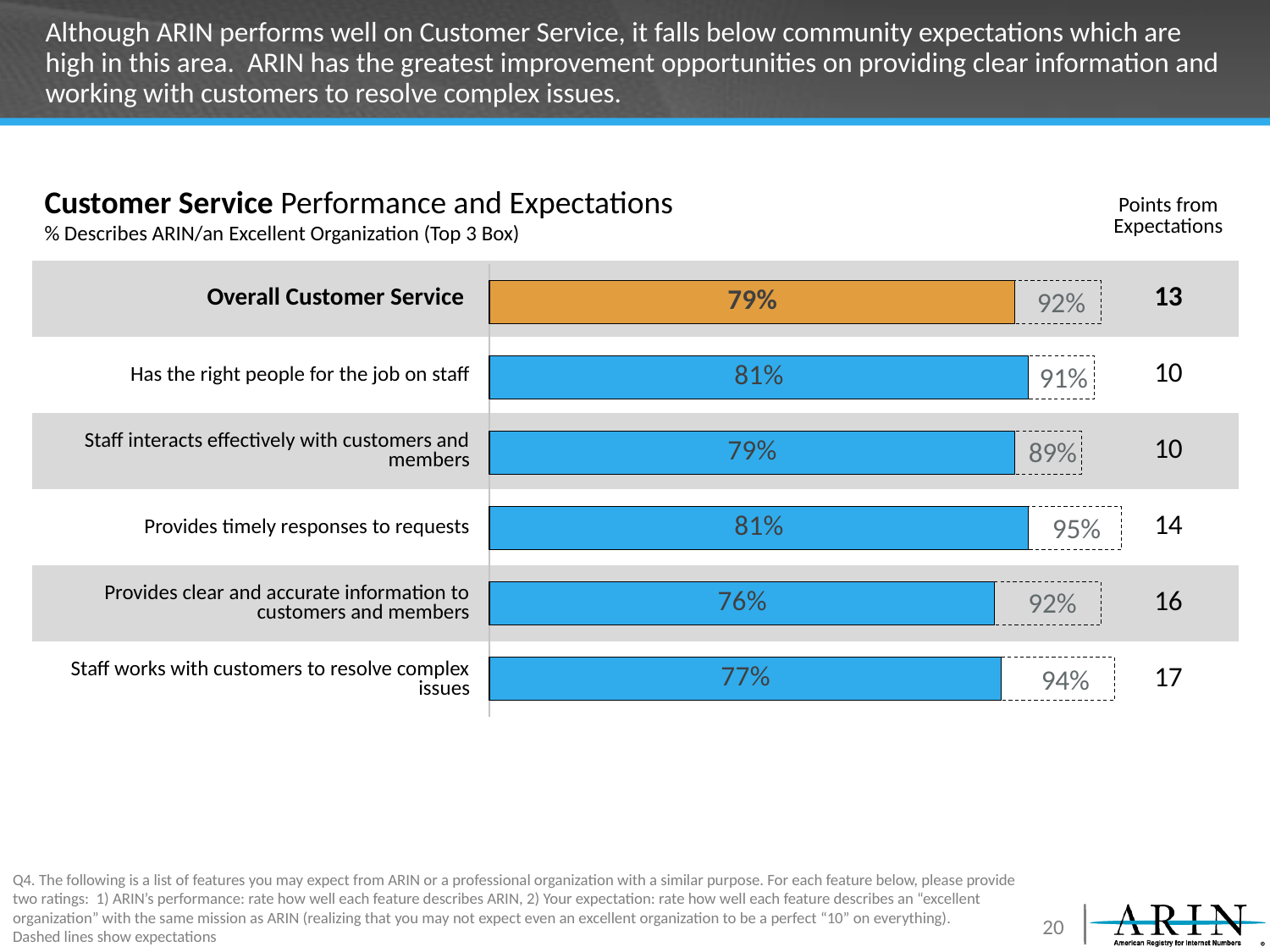
Which is larger: the performance value for Has the right people for the job on staff or the performance value for Staff works with customers to resolve complex issues? Has the right people for the job on staff Which category has the highest expectation value? Provides timely responses to requests What kind of chart is shown on the slide? Bar chart Which category's performance bar is coloured orange rather than blue? Overall Customer Service What is the performance value for Provides clear and accurate information to customers and members? 76% How many categories are shown in the chart? 6 What is the difference between the expectation and performance values for Staff works with customers to resolve complex issues? 17 According to the footnote, what do the dashed lines in the chart show? Expectations Which category has the lowest performance value? Provides clear and accurate information to customers and members What is ARIN's performance value for Overall Customer Service? 79% What is the 'Points from Expectations' value for Provides clear and accurate information to customers and members? 16 What is the expectation value (dashed bar) for Provides timely responses to requests? 95%